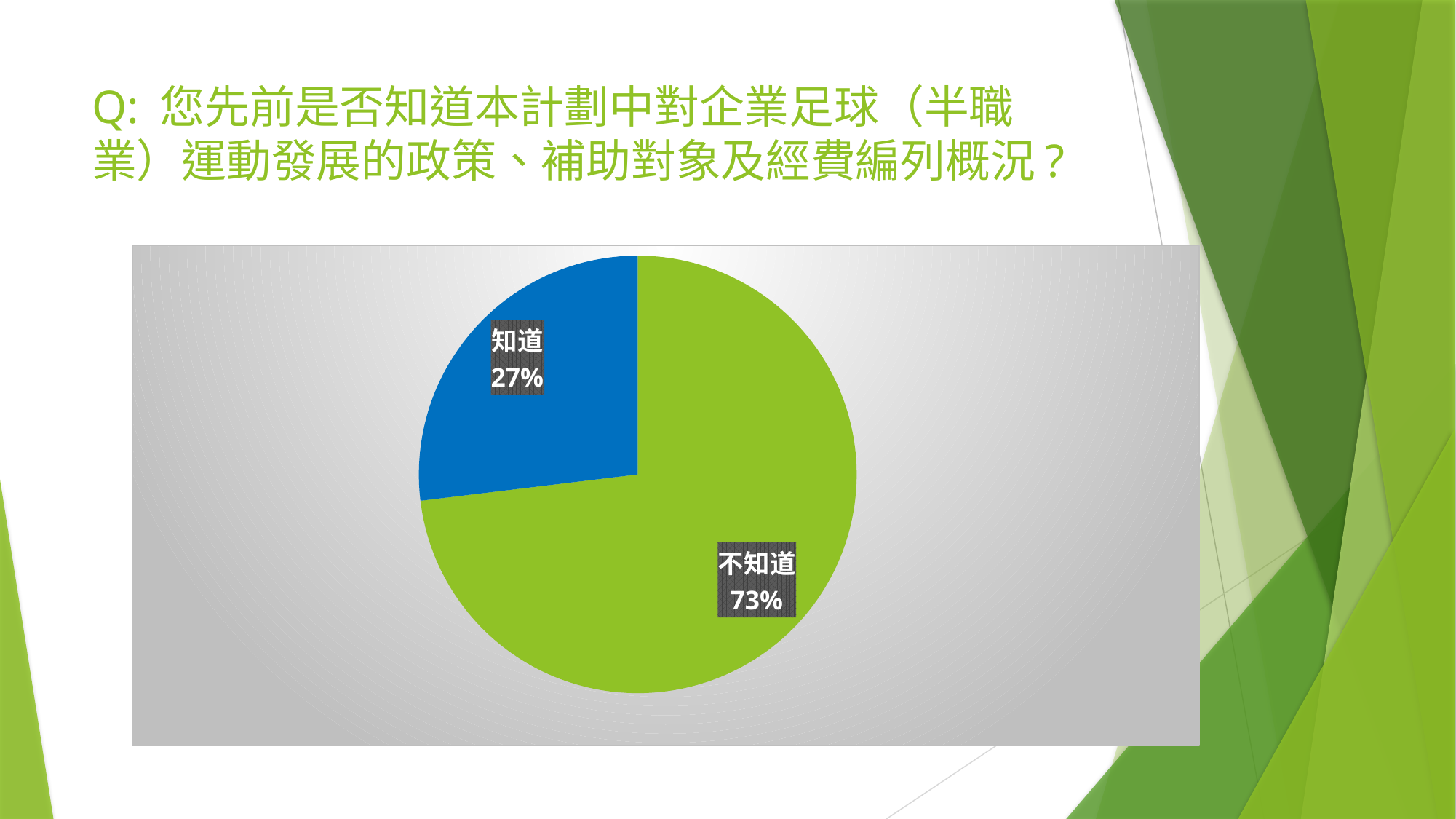
What colour is the 知道 slice? blue What is the difference in percentage points between 不知道 and 知道? 46 What kind of chart is shown on the slide? pie chart What percentage of respondents answered 不知道? 73% Which is larger, the share for 知道 or the share for 不知道? 不知道 Which slice of the pie is the smallest? 知道 What colour is the 不知道 slice? green How many slices does the pie chart have? 2 What share of the pie does the 不知道 slice represent? 73% Which slice of the pie is the largest? 不知道 What percentage of respondents answered 知道? 27%